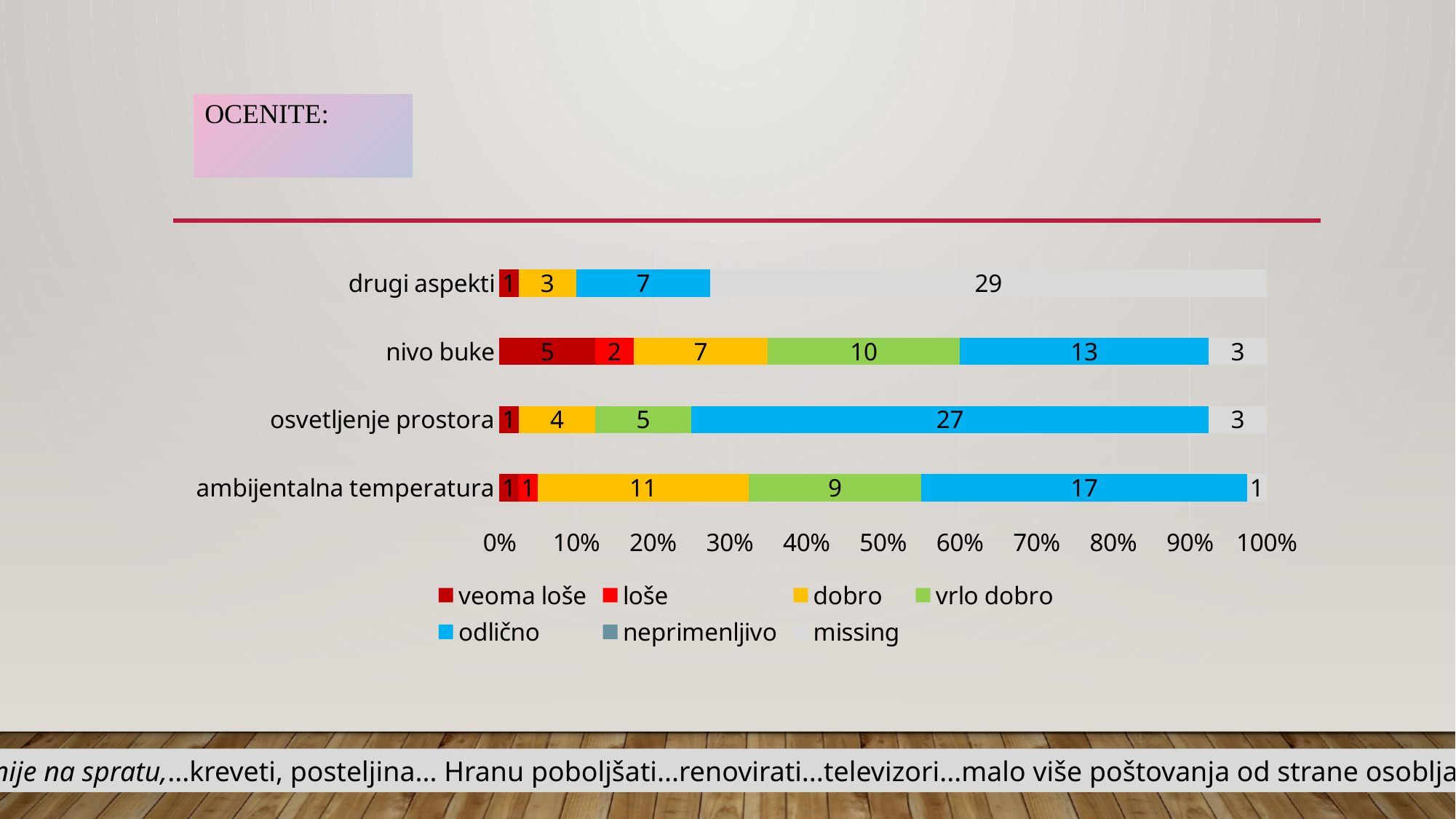
What is the 'odlično' value for 'osvetljenje prostora'? 27 What is the difference between the 'odlično' values for 'osvetljenje prostora' and 'nivo buke'? 14 What kind of chart is shown on the slide? stacked bar chart What is the 'dobro' value for 'ambijentalna temperatura'? 11 Which category has the lowest 'odlično' value? drugi aspekti How many categories are shown on the chart? 4 Which is larger: the 'dobro' value for 'ambijentalna temperatura' or the 'dobro' value for 'nivo buke'? ambijentalna temperatura What is the 'missing' value for 'drugi aspekti'? 29 What is the total of the stacked bar for 'nivo buke'? 40 Which category has the highest 'veoma loše' value? nivo buke How many series does the legend list? 7 What is the 'vrlo dobro' value for 'nivo buke'? 10